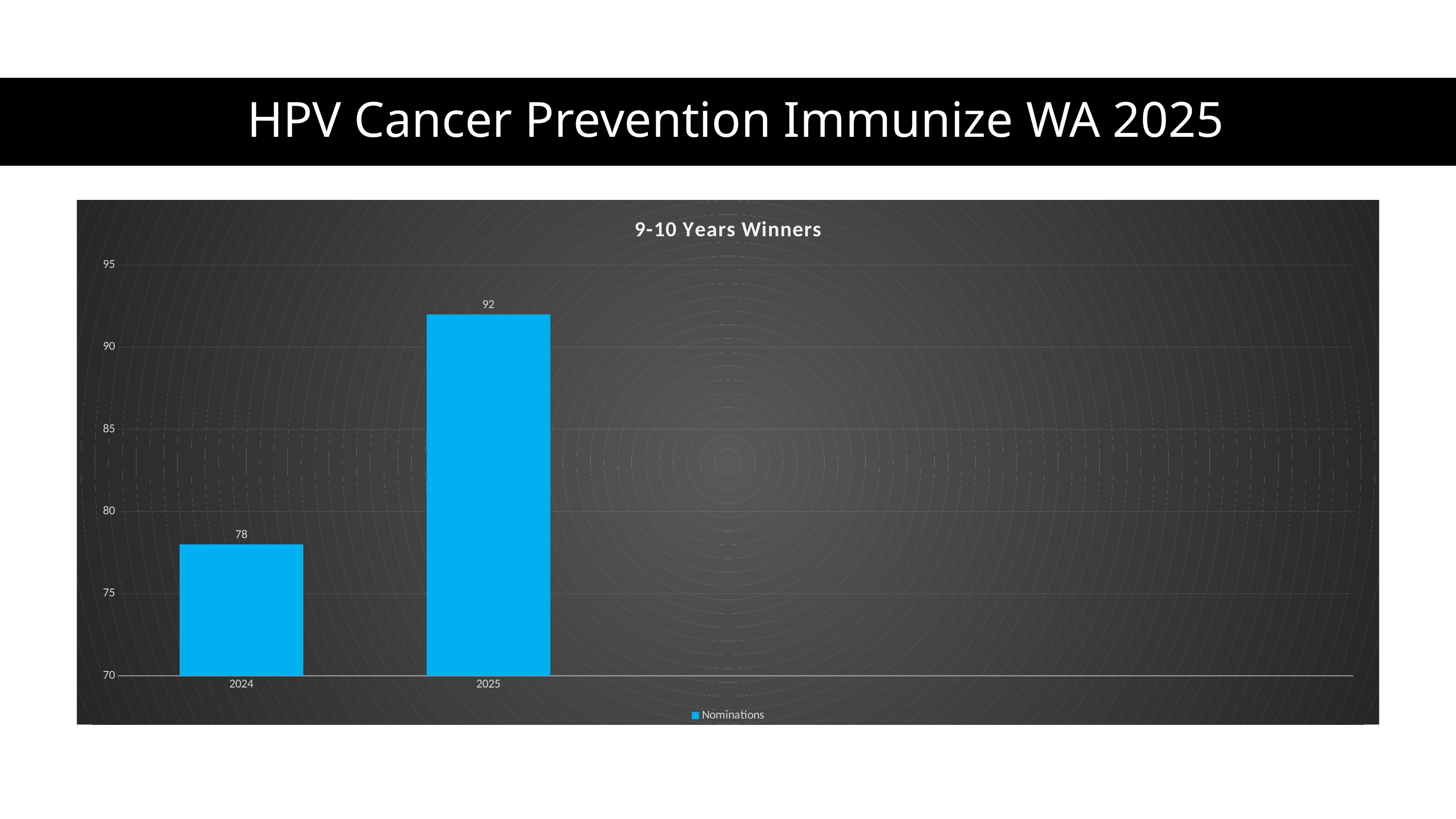
What is the title of the chart? 9-10 Years Winners What kind of chart is shown? bar chart What is the value for 2024? 78 Is the value for 2025 greater or less than 90? greater What is the value for 2025? 92 Which year has the lowest value? 2024 Which is larger, the value for 2024 or the value for 2025? 2025 How many categories are shown on the x axis? 2 How many series does the legend list? 1 Which year has the highest value? 2025 What is the difference between the values for 2025 and 2024? 14 Is the value for 2024 greater or less than 80? less